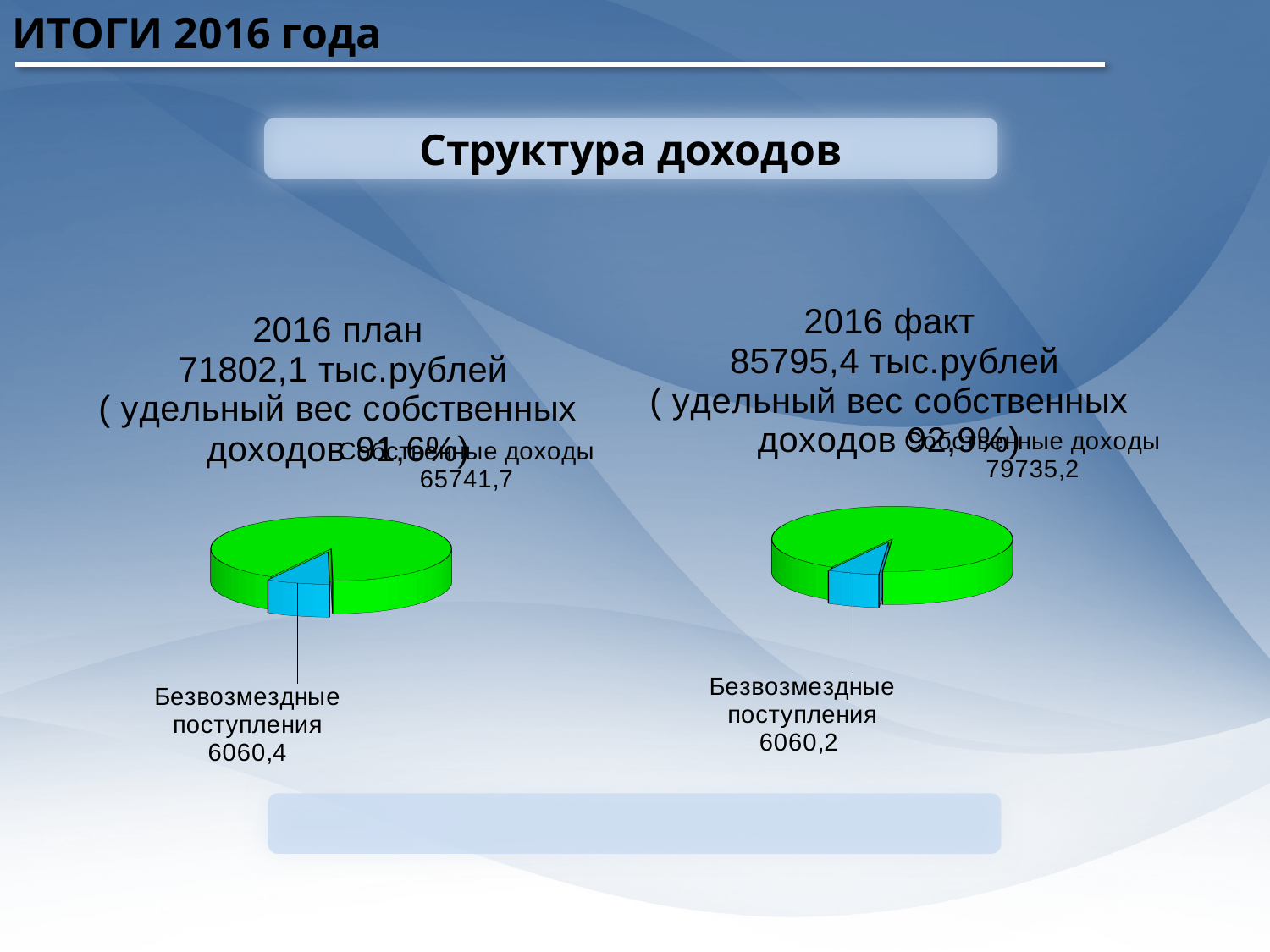
On the right chart (2016 факт), what is the value for Безвозмездные поступления? 6060,2 On the left chart (2016 план), what is the value for Безвозмездные поступления? 6060,4 On the right chart (2016 факт), what colour is the Безвозмездные поступления slice? Blue On the right chart (2016 факт), what is the total of the two slices? 85795,4 What kind of chart is used on the right (2016 факт)? Pie chart On the left chart (2016 план), what is the difference between Собственные доходы and Безвозмездные поступления? 59681,3 On the left chart (2016 план), which category has the largest slice? Собственные доходы Which is larger: Собственные доходы on the left chart (2016 план) or Собственные доходы on the right chart (2016 факт)? 2016 факт On the right chart (2016 факт), what is the value for Собственные доходы? 79735,2 How many slices does the left chart (2016 план) have? 2 On the right chart (2016 факт), which category has the smallest slice? Безвозмездные поступления On the left chart (2016 план), what is the value for Собственные доходы? 65741,7